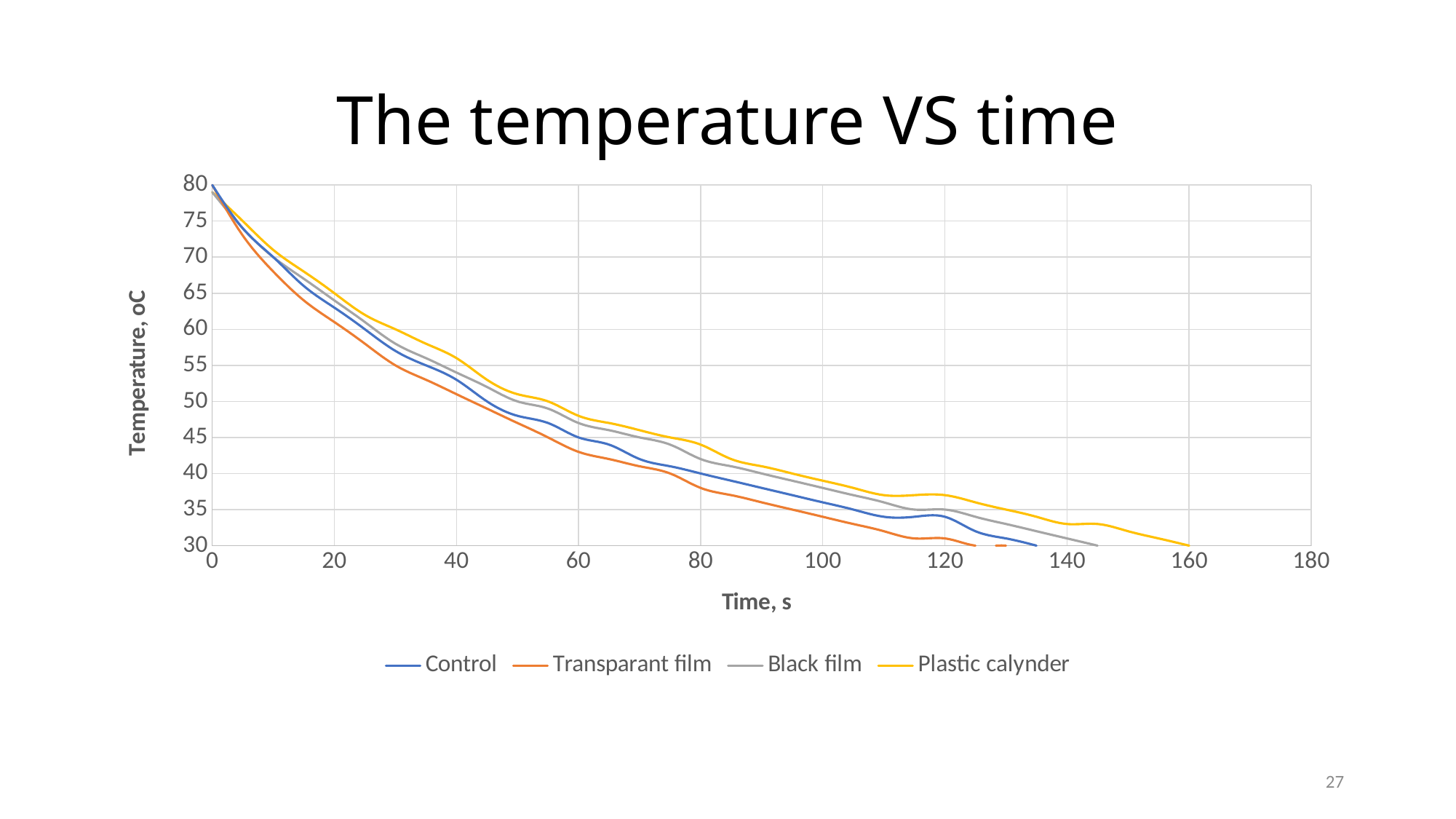
Is the value for Plastic calynder at time 120 greater or less than 35? greater What is the label of the x axis? Time, s Is the value for Transparant film at time 60 greater or less than 45? less Is the value for Plastic calynder at time 60 greater or less than 45? greater What is the title of the chart? The temperature VS time At time 100, which is higher: Plastic calynder or Control? Plastic calynder What is the Control temperature at time 0? 80 What kind of chart is shown on the slide? line chart Which series takes the longest time to cool to 30? Plastic calynder How many series does the legend list? 4 Do the temperature values rise or fall as time increases? fall